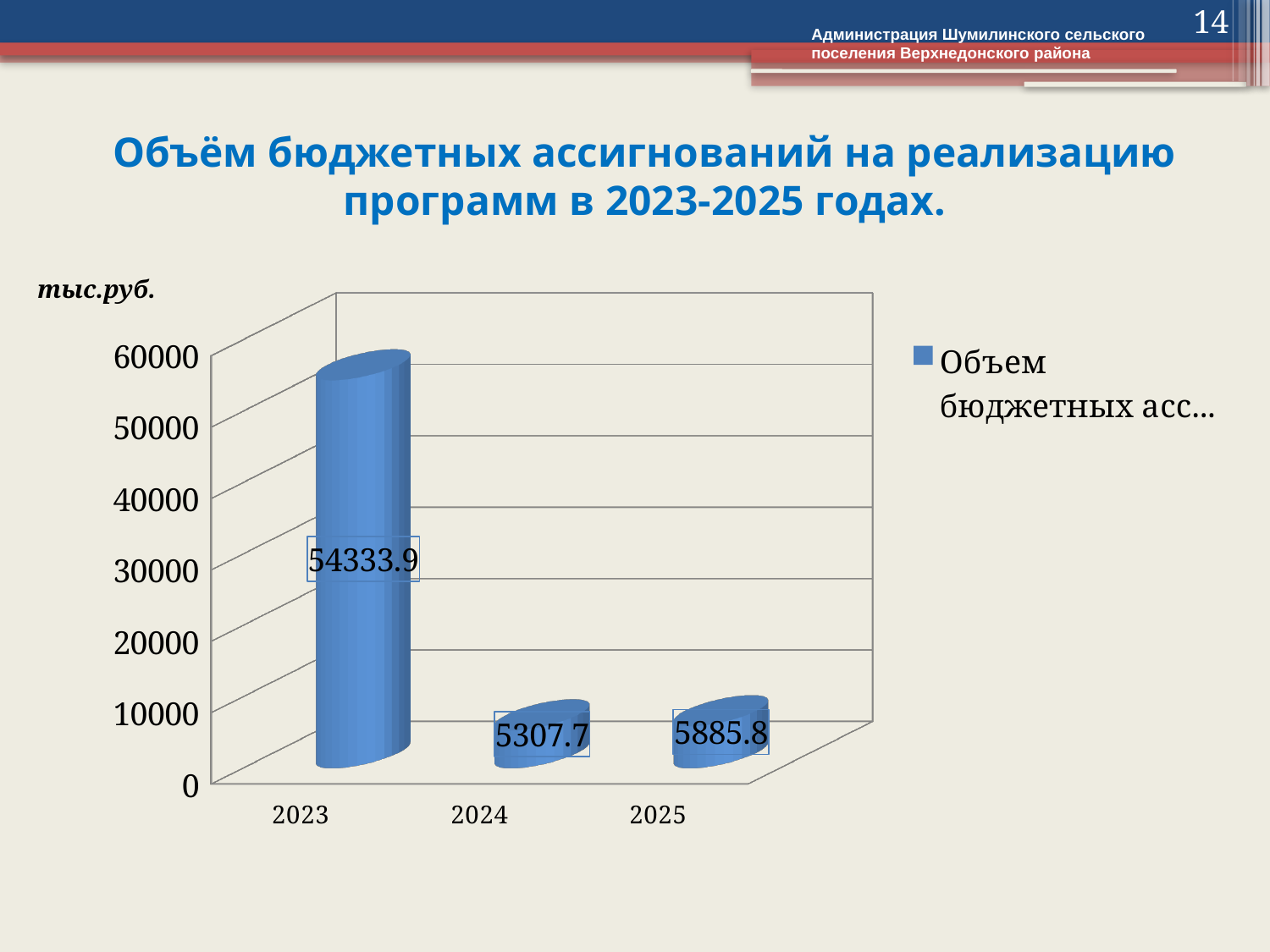
Does the value rise or fall from 2023 to 2024? fall What is the value for 2025? 5885.8 Which is larger, the value for 2024 or the value for 2025? 2025 What is the value for 2024? 5307.7 What is the value for 2023? 54333.9 What is the difference between the values for 2025 and 2024? 578.1 What is the difference between the values for 2023 and 2024? 49026.2 How many years are shown on the x axis? 3 Is the value for 2023 greater or less than 50000? greater Which year has the lowest value? 2024 What kind of chart is shown on the slide? bar chart Which year has the highest value? 2023